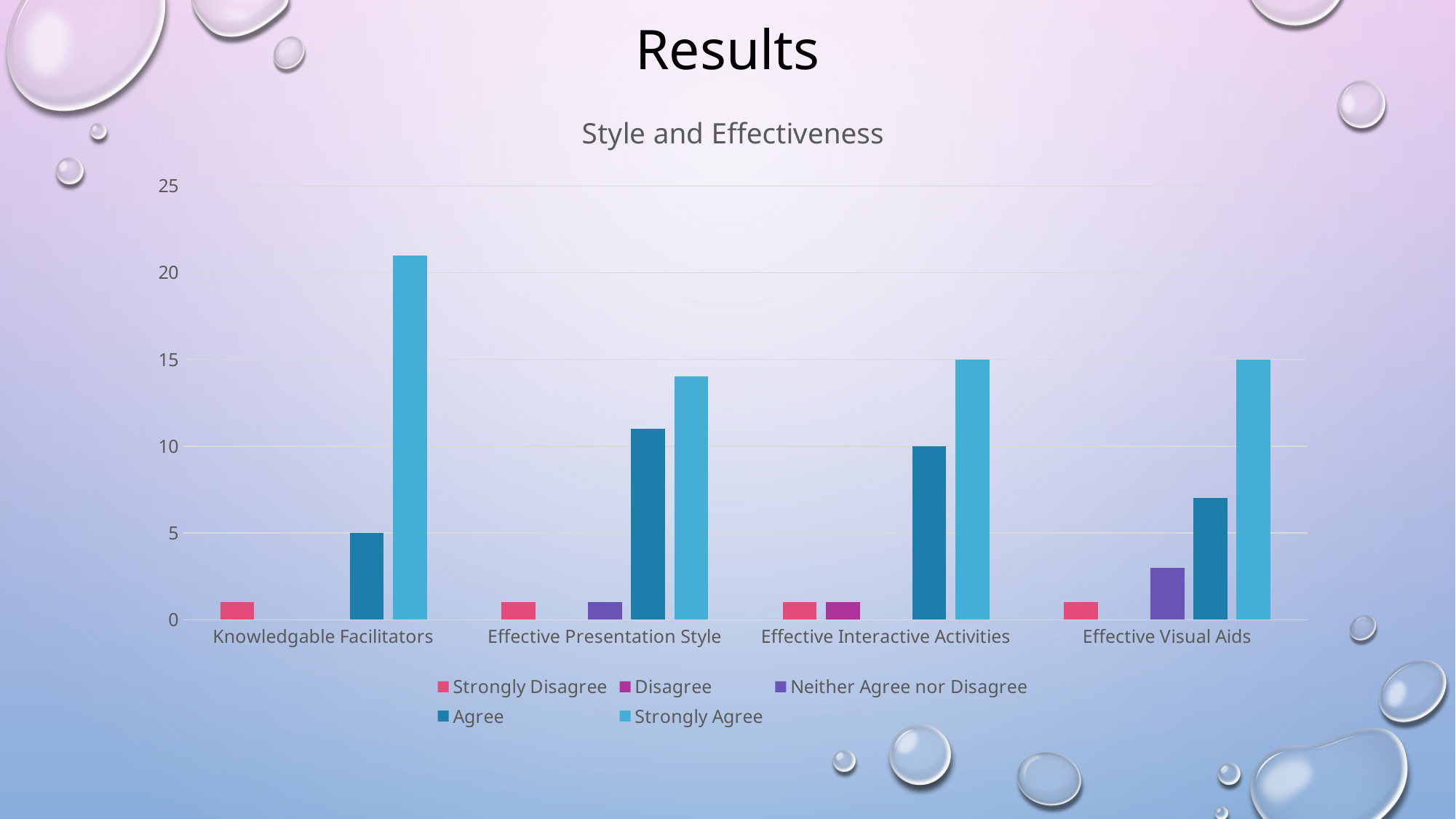
Which category has the lowest Agree value? Knowledgable Facilitators Which category has the highest Strongly Agree value? Knowledgable Facilitators How many categories are shown on the x axis? 4 Is the Strongly Agree value for Knowledgable Facilitators greater or less than 20? greater What is the Agree value for Knowledgable Facilitators? 5 Is the Agree value for Effective Visual Aids greater or less than 10? less What kind of chart is shown on the slide? bar chart Which is larger for Effective Presentation Style, the Agree value or the Strongly Agree value? Strongly Agree What is the Agree value for Effective Interactive Activities? 10 How many series does the legend list? 5 What is the title of the chart? Style and Effectiveness What is the Strongly Agree value for Effective Visual Aids? 15